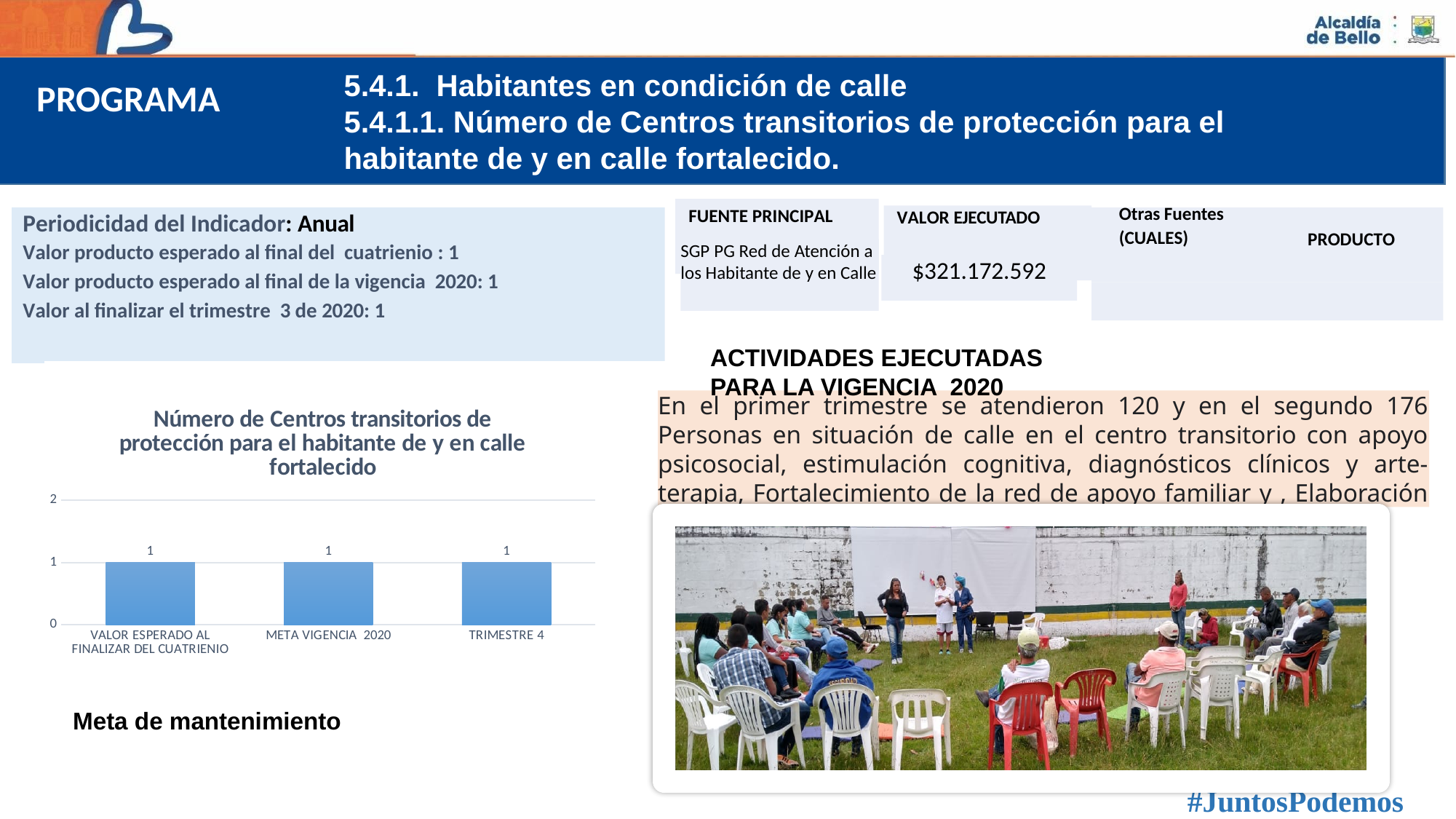
What type of chart is shown on the slide? Bar chart What is the title of the chart? Número de Centros transitorios de protección para el habitante de y en calle fortalecido What is the value for TRIMESTRE 4? 1 What is the value for VALOR ESPERADO AL FINALIZAR DEL CUATRIENIO? 1 How many categories are plotted in the chart? 3 Do the values rise, fall or stay the same across the categories from left to right? Stay the same What is the difference between the value for META VIGENCIA 2020 and the value for TRIMESTRE 4? 0 Is the value for TRIMESTRE 4 greater or less than 2? less What is the highest value shown on the chart's vertical axis? 2 What is the value for META VIGENCIA 2020? 1